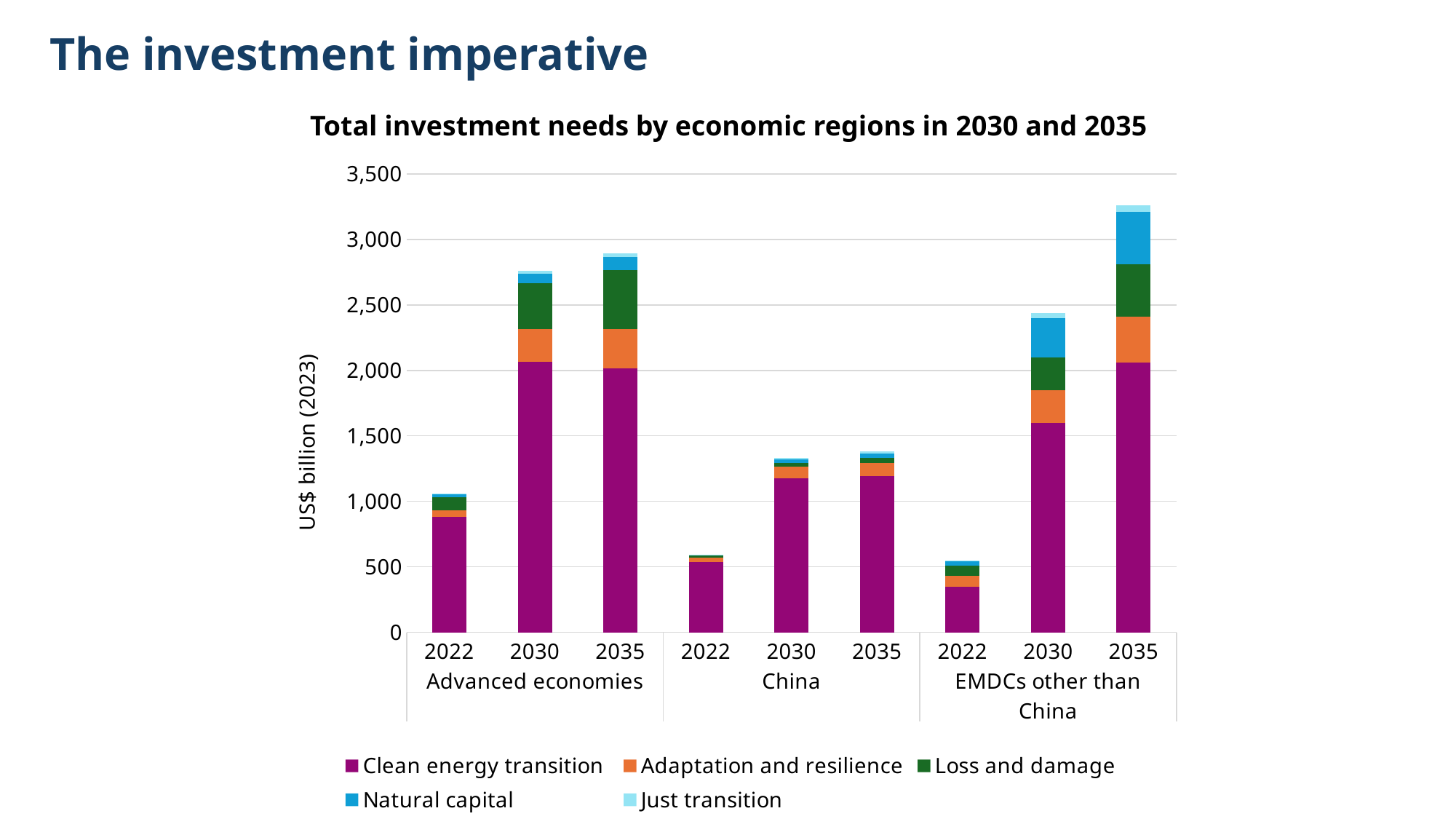
Is the total for Advanced economies in 2030 greater or less than 2,500? greater What is the title of the chart? Total investment needs by economic regions in 2030 and 2035 Which is larger in 2030: the total for Advanced economies or for EMDCs other than China? Advanced economies Within each economic region, do the total investment needs rise or fall from 2022 to 2035? rise How many series does the legend list? 5 Which bar has the highest total investment need? EMDCs other than China, 2035 Is the total for China in 2030 greater or less than 1,000? greater What kind of chart is shown on the slide? Stacked bar chart What unit is shown on the vertical axis label? US$ billion (2023) Is the total for EMDCs other than China in 2035 greater or less than 3,000? greater How many bars are plotted in the chart? 9